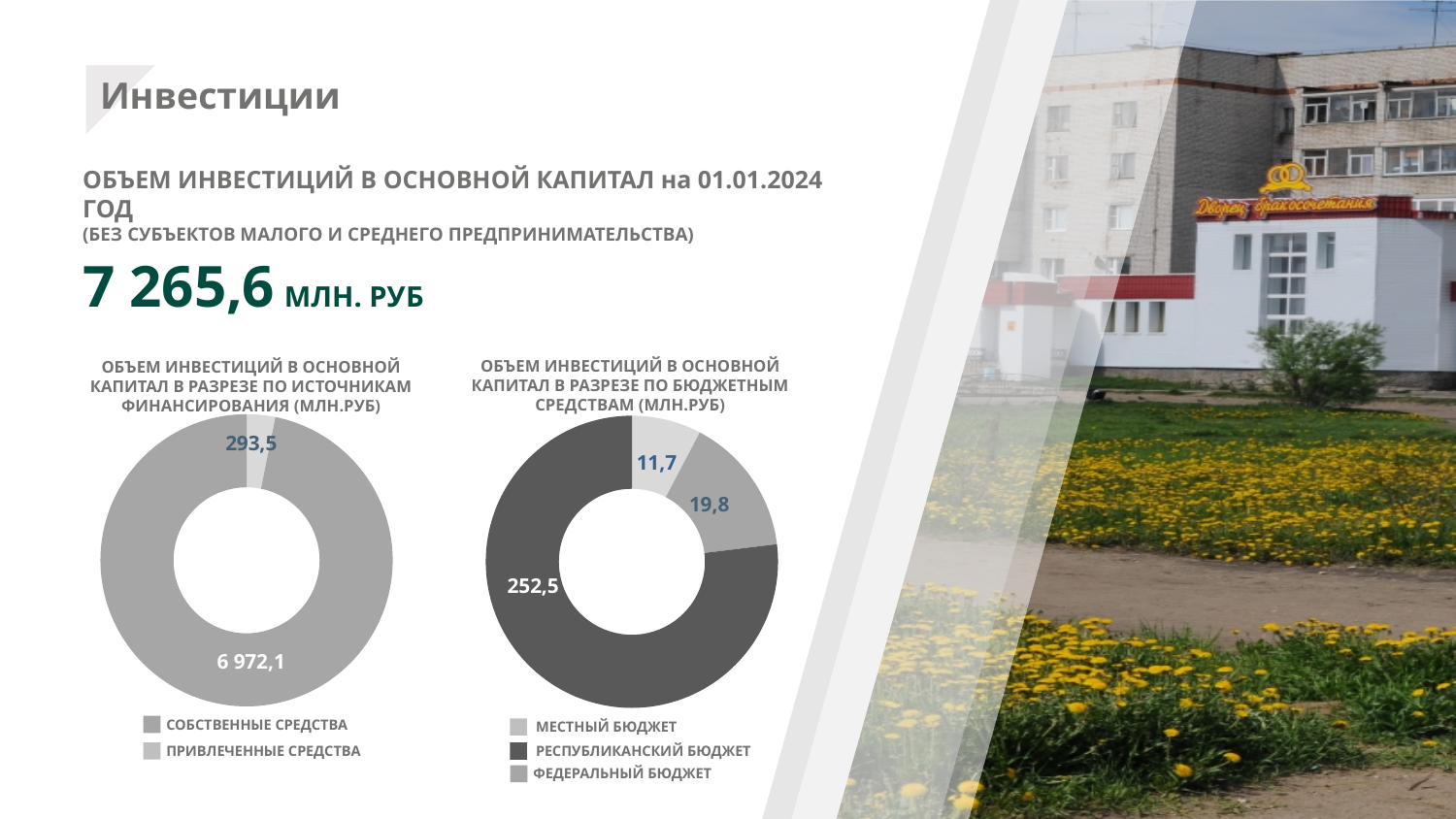
In the right chart (по бюджетным средствам), what is the value for 'Федеральный бюджет'? 19,8 In the left chart (по источникам финансирования), which source has the larger value? Собственные средства In the right chart (по бюджетным средствам), what is the total of the three budget values? 284,0 In the left chart (по источникам финансирования), what is the value for 'Собственные средства'? 6 972,1 In the left chart (по источникам финансирования), what is the difference between 'Собственные средства' and 'Привлеченные средства'? 6 678,6 What type of chart is used for 'Объем инвестиций в основной капитал в разрезе по источникам финансирования'? Donut (pie) chart How many categories does the legend of the right chart (по бюджетным средствам) list? 3 In the right chart (по бюджетным средствам), which budget has the smallest value? Местный бюджет In the right chart (по бюджетным средствам), what is the value for 'Местный бюджет'? 11,7 How many categories does the legend of the left chart (по источникам финансирования) list? 2 In the left chart (по источникам финансирования), what is the value for 'Привлеченные средства'? 293,5 In the right chart (по бюджетным средствам), what is the value for 'Республиканский бюджет'? 252,5